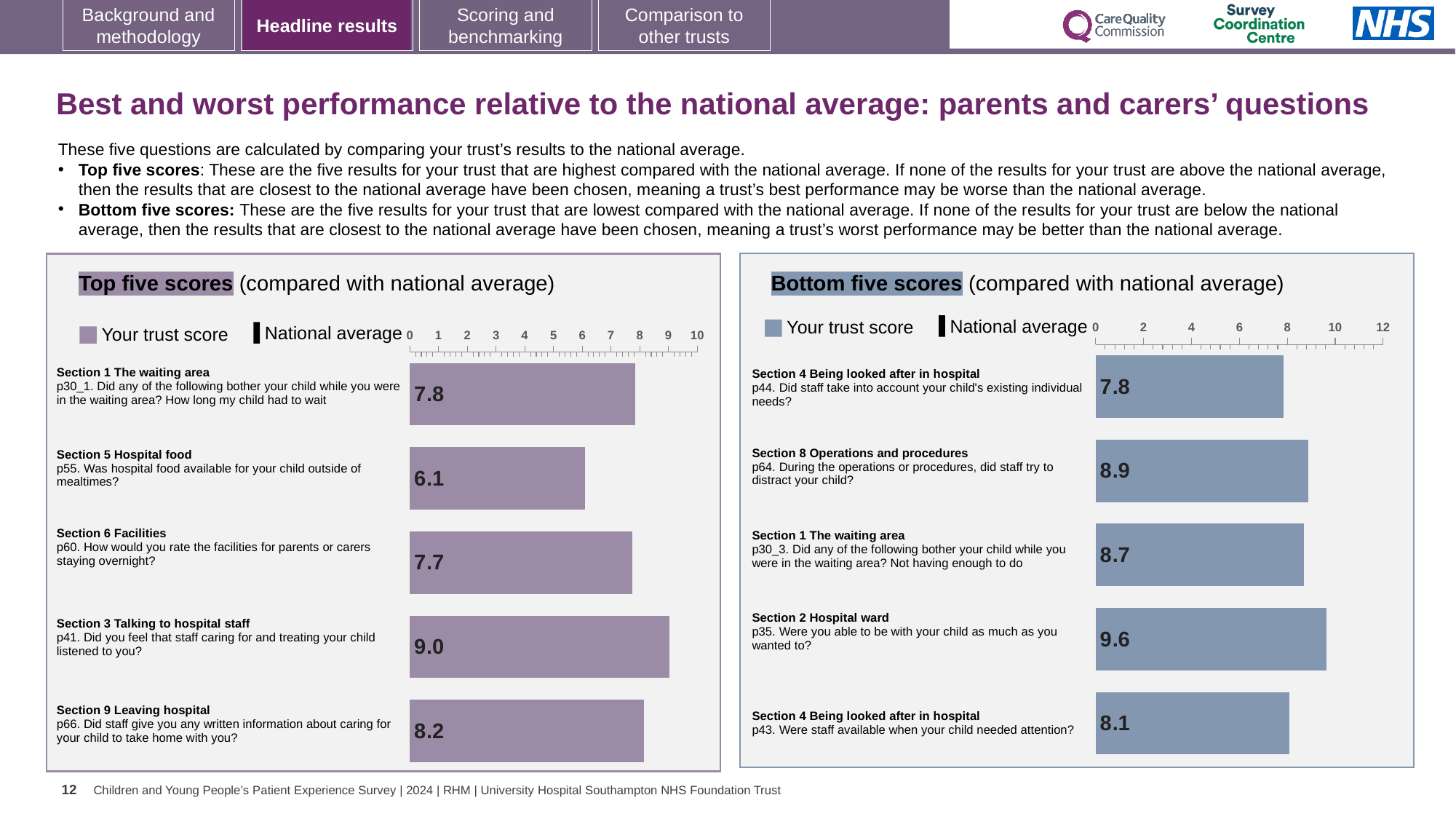
In the Bottom five scores chart, what is the trust score for p35 (Were you able to be with your child as much as you wanted to?)? 9.6 In the Bottom five scores chart, which question has the lowest trust score? p44. Did staff take into account your child's existing individual needs? In the Top five scores chart, what is the difference between the trust scores for p41 and p55? 2.9 In the Top five scores chart, which question has the lowest trust score? p55. Was hospital food available for your child outside of mealtimes? How many questions are shown in the Bottom five scores chart? 5 In the Top five scores chart, which question has the highest trust score? p41. Did you feel that staff caring for and treating your child listened to you? What type of chart is the Top five scores chart? Bar chart In the Top five scores chart, what is the trust score for p41 (Did you feel that staff caring for and treating your child listened to you?)? 9.0 In the Bottom five scores chart, what is the difference between the trust scores for p35 and p44? 1.8 In the Bottom five scores chart, what is the trust score for p43 (Were staff available when your child needed attention?)? 8.1 In the Bottom five scores chart, which has the larger trust score: p64 or p30_3? p64 In the Top five scores chart, what is the trust score for p55 (Was hospital food available for your child outside of mealtimes?)? 6.1